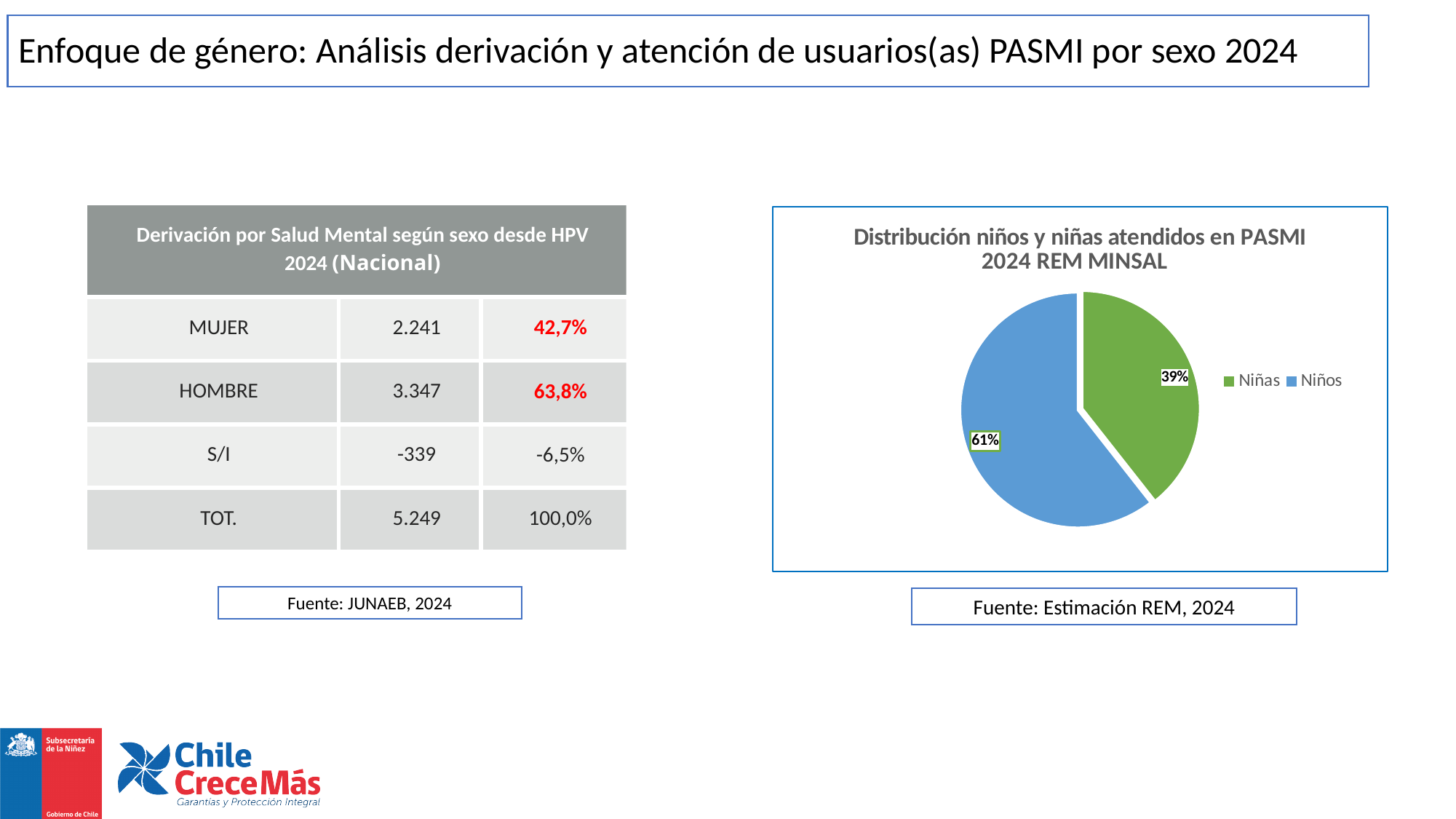
Which slice of the pie chart is the smallest? Niñas In the pie chart, which is larger, the share for Niñas or the share for Niños? Niños What kind of chart is shown on the slide? pie chart What is the title of the pie chart? Distribución niños y niñas atendidos en PASMI 2024 REM MINSAL In the pie chart, what share is labelled for Niños? 61% What is the difference in percentage points between the Niños and Niñas slices of the pie chart? 22% Is the share for Niños in the pie chart greater or less than 50%? greater How many slices does the pie chart have? 2 In the pie chart, what share is labelled for Niñas? 39% How many entries does the legend of the pie chart list? 2 Which slice of the pie chart is the largest? Niños What colour is the Niñas slice in the pie chart? green